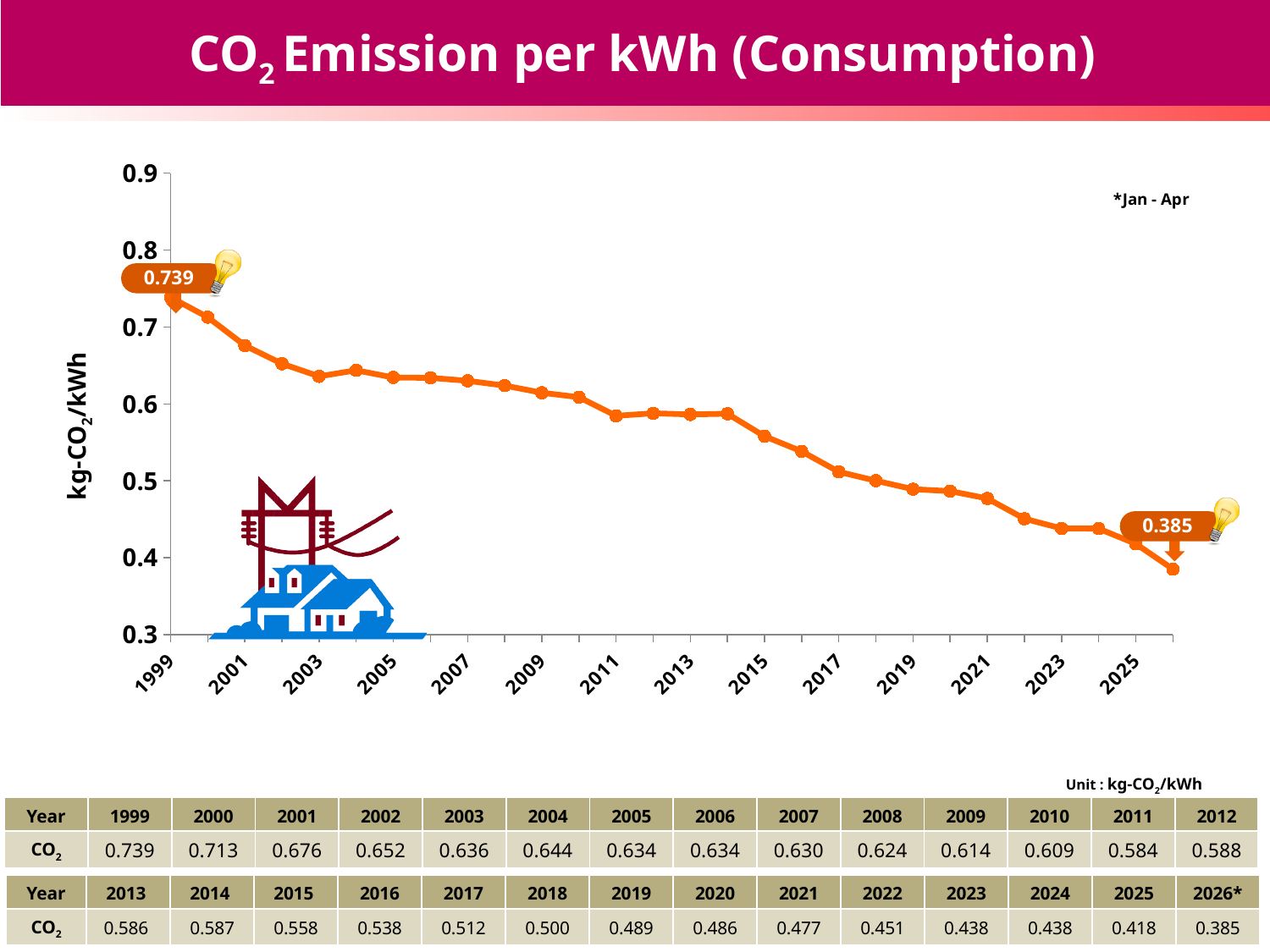
What unit is shown on the y axis of the chart? kg-CO2/kWh Which year has a higher CO2 emission per kWh, 2004 or 2015? 2004 What is the CO2 emission per kWh value for 2026*? 0.385 What is the difference between the CO2 emission per kWh in 1999 and in 2026*? 0.354 What kind of chart is shown on the slide? line chart Which year has the lowest CO2 emission per kWh? 2026* What is the CO2 emission per kWh value for 2018? 0.500 Do the CO2 emission per kWh values generally rise or fall from 1999 to 2026*? fall Which year has the highest CO2 emission per kWh? 1999 What is the CO2 emission per kWh value for 2010? 0.609 What is the CO2 emission per kWh value for 1999? 0.739 Is the CO2 emission per kWh value for 2021 greater or less than 0.5? less